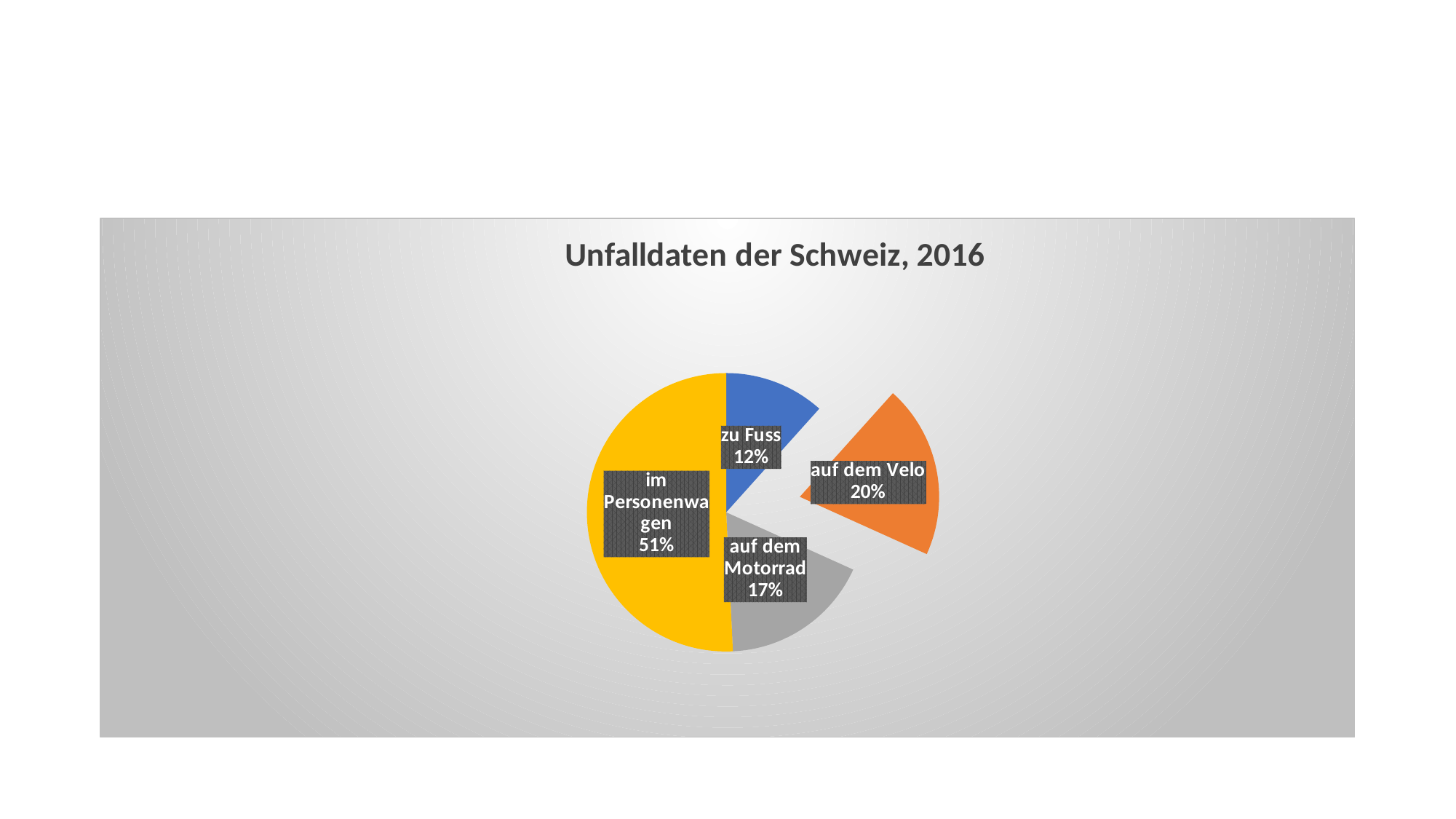
How many slices does the pie chart have? 4 What is the title of the chart? Unfalldaten der Schweiz, 2016 Which category has the largest share of the pie? im Personenwagen What share of the pie is 'auf dem Velo'? 20% What is the difference in percentage points between 'auf dem Velo' and 'auf dem Motorrad'? 3 Which is larger, the share for 'auf dem Velo' or the share for 'zu Fuss'? auf dem Velo What share of the pie is 'im Personenwagen'? 51% What share of the pie is 'zu Fuss'? 12% Which slice is pulled out (exploded) from the pie? auf dem Velo Which category has the smallest share of the pie? zu Fuss What kind of chart is shown on the slide? pie chart